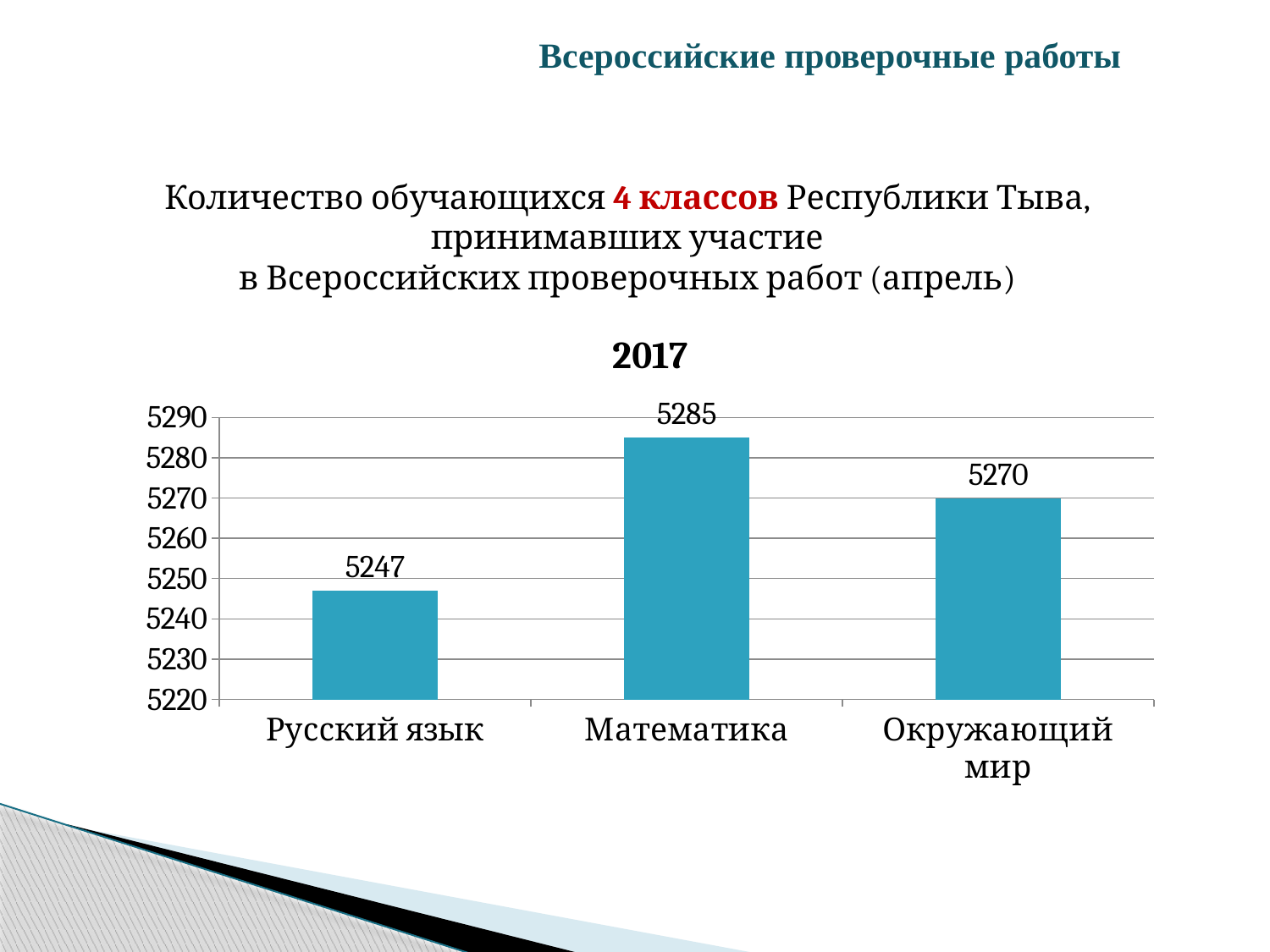
Which is larger, the value for Окружающий мир or the value for Русский язык? Окружающий мир What is the title of the chart? 2017 What is the value for Математика? 5285 How many categories are shown in the chart? 3 Which category has the highest value? Математика What is the difference between the values for Математика and Русский язык? 38 Which category has the lowest value? Русский язык Is the value for Русский язык greater or less than 5250? less What is the value for Русский язык? 5247 What is the value for Окружающий мир? 5270 What is the difference between the values for Математика and Окружающий мир? 15 What kind of chart is shown on the slide? bar chart